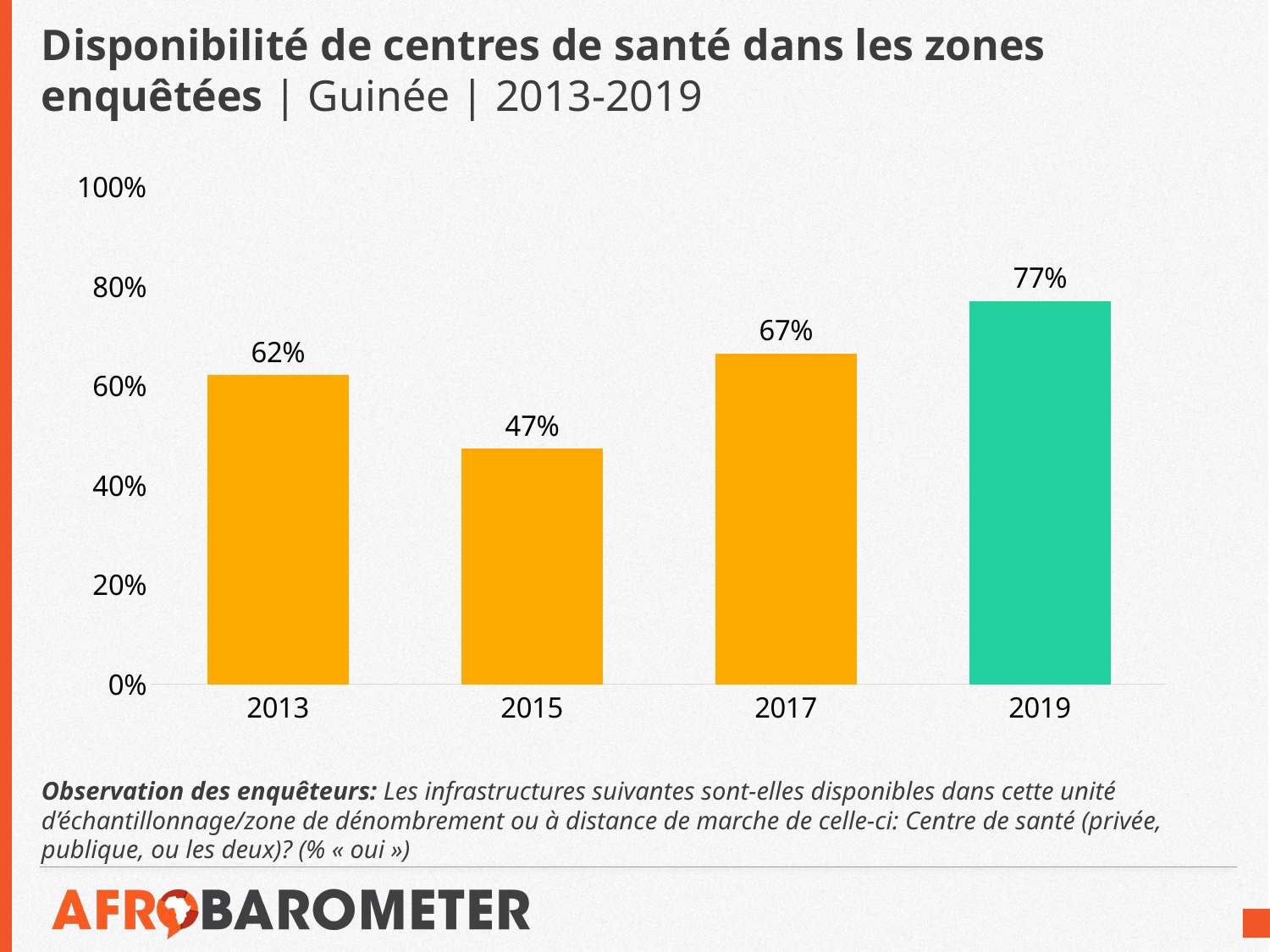
Which year has the lowest value? 2015 How many years are shown on the x axis? 4 Which year has the highest value? 2019 What is the value for 2015? 47% Which bar is shown in a different colour (green) from the others? 2019 Which is larger, the value for 2013 or the value for 2017? 2017 What kind of chart is shown on the slide? Bar chart What is the difference between the values for 2019 and 2013? 15% What is the value for 2013? 62% What is the value for 2017? 67% What is the value for 2019? 77% What is the difference between the values for 2017 and 2015? 20%